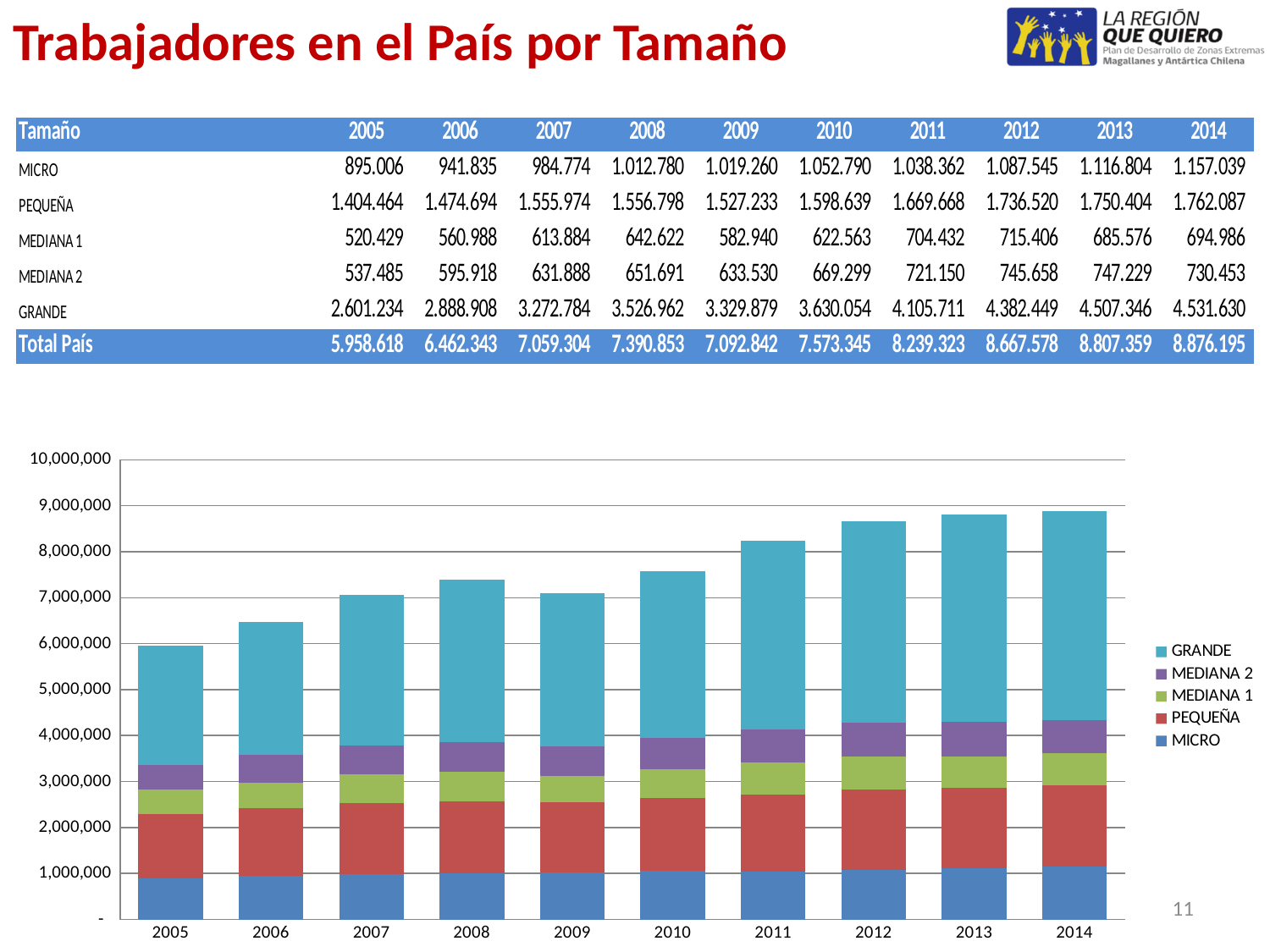
Which year has the lowest total number of workers? 2005 Which series is listed first (at the top) in the chart legend? GRANDE What kind of chart is shown on the slide? bar chart How many years are plotted along the x axis of the chart? 10 How many series does the chart legend list? 5 What is the difference between the MICRO value in 2014 and the MICRO value in 2005? 262.033 Do the total bar heights generally rise or fall from 2005 to 2014? rise In 2005, which is larger: GRANDE or PEQUEÑA? GRANDE Is the total for 2011 greater or less than 8,000,000? greater Which year has the highest total number of workers? 2014 What is the total (Total País) of the stacked bar for 2010? 7.573.345 What is the value for GRANDE in 2014? 4.531.630